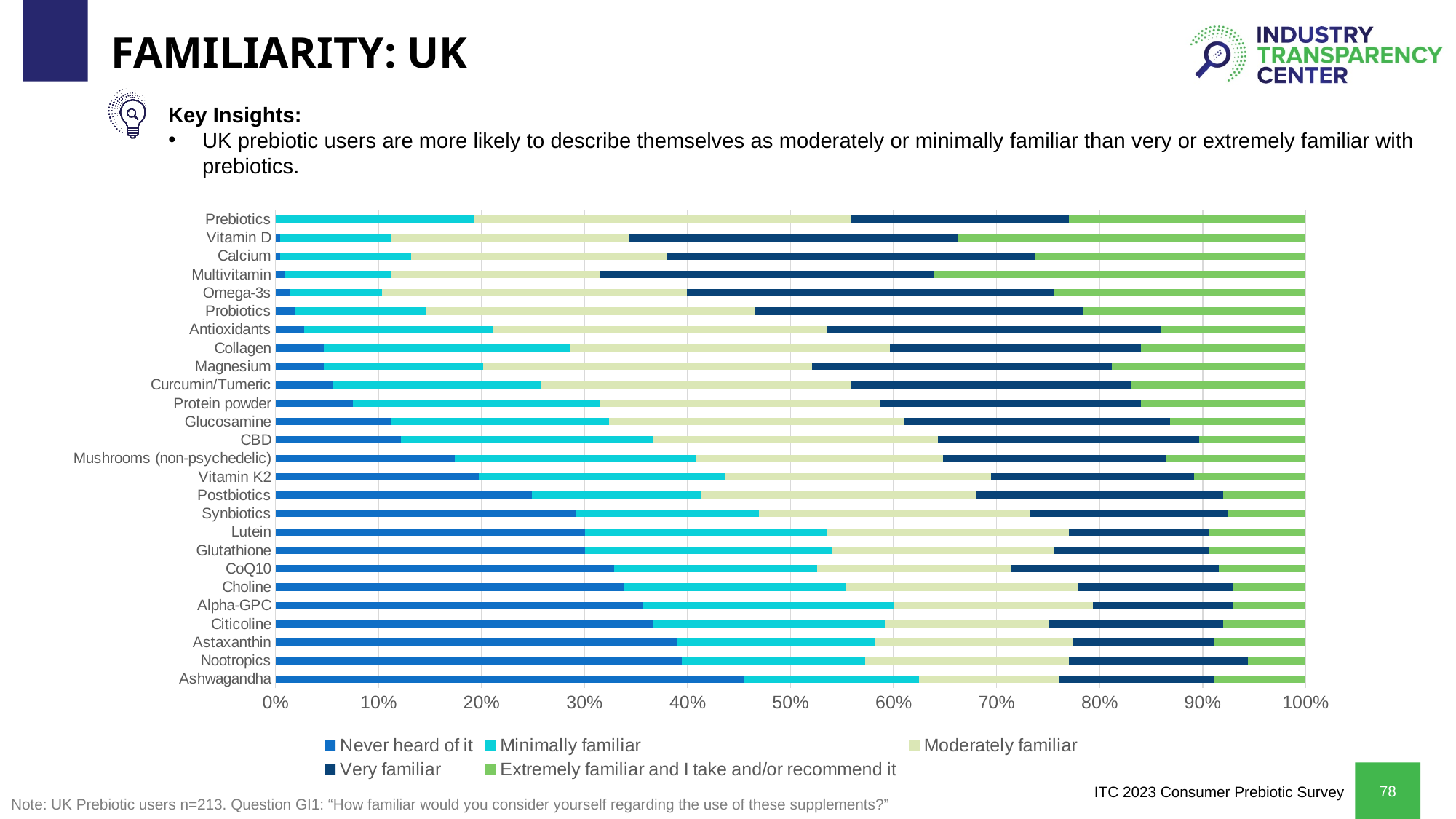
Moving from the top category (Prebiotics) to the bottom (Ashwagandha), does the 'Never heard of it' segment generally get larger or smaller? larger What is the title of the slide containing the chart? FAMILIARITY: UK How many series does the chart legend list? 5 Is the 'Never heard of it' share for Ashwagandha greater or less than 40%? greater Which supplement has the largest 'Never heard of it' share? Ashwagandha Is the 'Never heard of it' share for Postbiotics greater or less than 20%? greater Is the 'Never heard of it' share for Choline greater or less than 30%? greater Which has a larger 'Never heard of it' share, Ashwagandha or Prebiotics? Ashwagandha What kind of chart is shown on the slide? Stacked bar chart How many supplement categories are listed on the chart? 26 Which has a larger 'Never heard of it' share, Postbiotics or Vitamin K2? Postbiotics